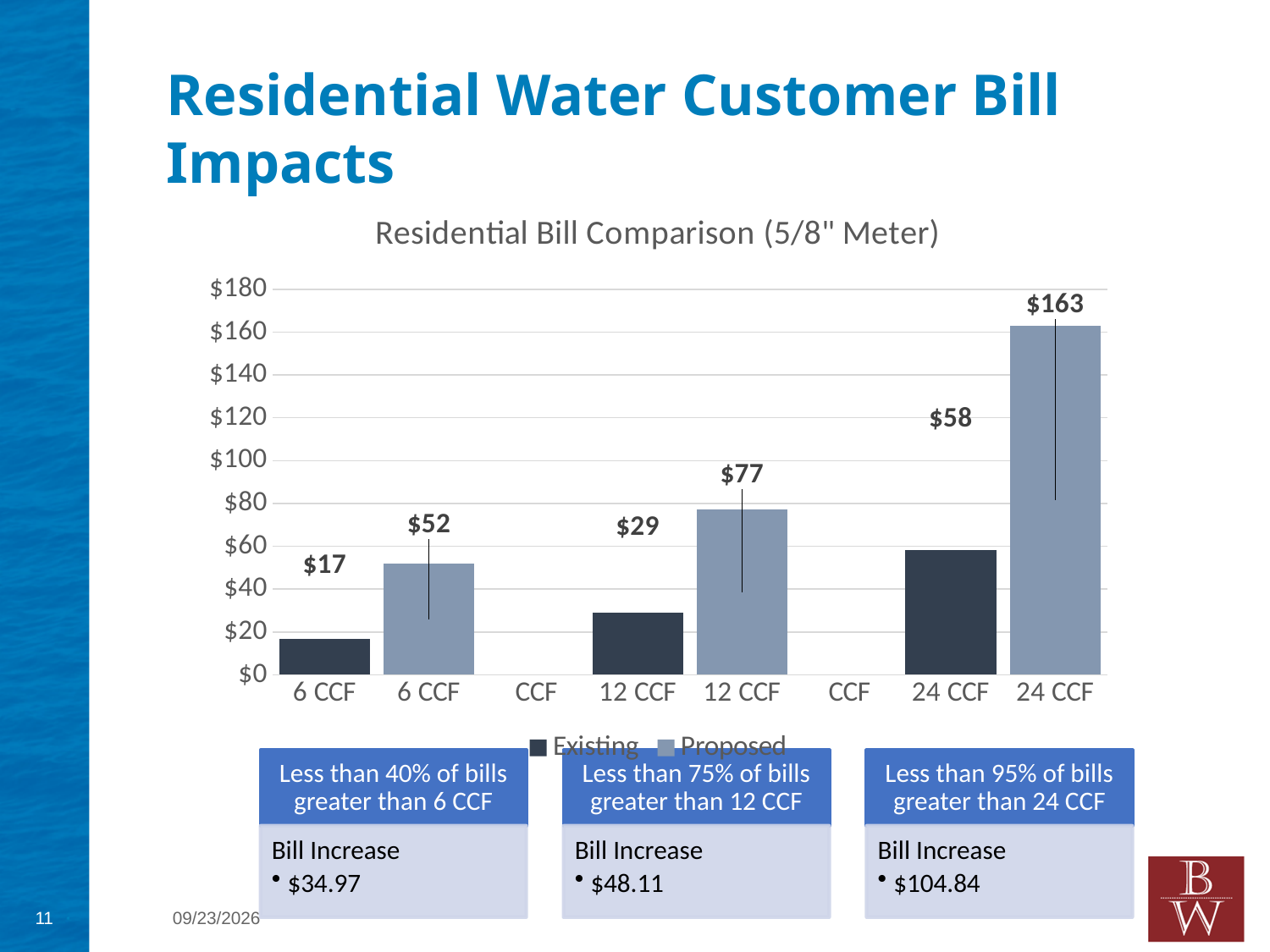
Do the Proposed bill values rise or fall as usage increases from 6 CCF to 24 CCF in the Residential Bill Comparison chart? Rise What is the Proposed bill value for 24 CCF in the Residential Bill Comparison chart? $163 What is the Existing bill value for 24 CCF in the Residential Bill Comparison chart? $58 What is the Existing bill value for 6 CCF in the Residential Bill Comparison chart? $17 What is the difference between the Proposed and Existing bills for 24 CCF in the Residential Bill Comparison chart? $105 How many series does the legend of the Residential Bill Comparison chart list? 2 Which bar has the lowest value in the Residential Bill Comparison chart? 6 CCF Existing Which bar has the highest value in the Residential Bill Comparison chart? 24 CCF Proposed What is the difference between the Proposed and Existing bills for 12 CCF in the Residential Bill Comparison chart? $48 Which is larger in the Residential Bill Comparison chart: the Proposed bill for 6 CCF or the Existing bill for 12 CCF? Proposed bill for 6 CCF What kind of chart is the Residential Bill Comparison chart? Bar chart What is the Proposed bill value for 12 CCF in the Residential Bill Comparison chart? $77